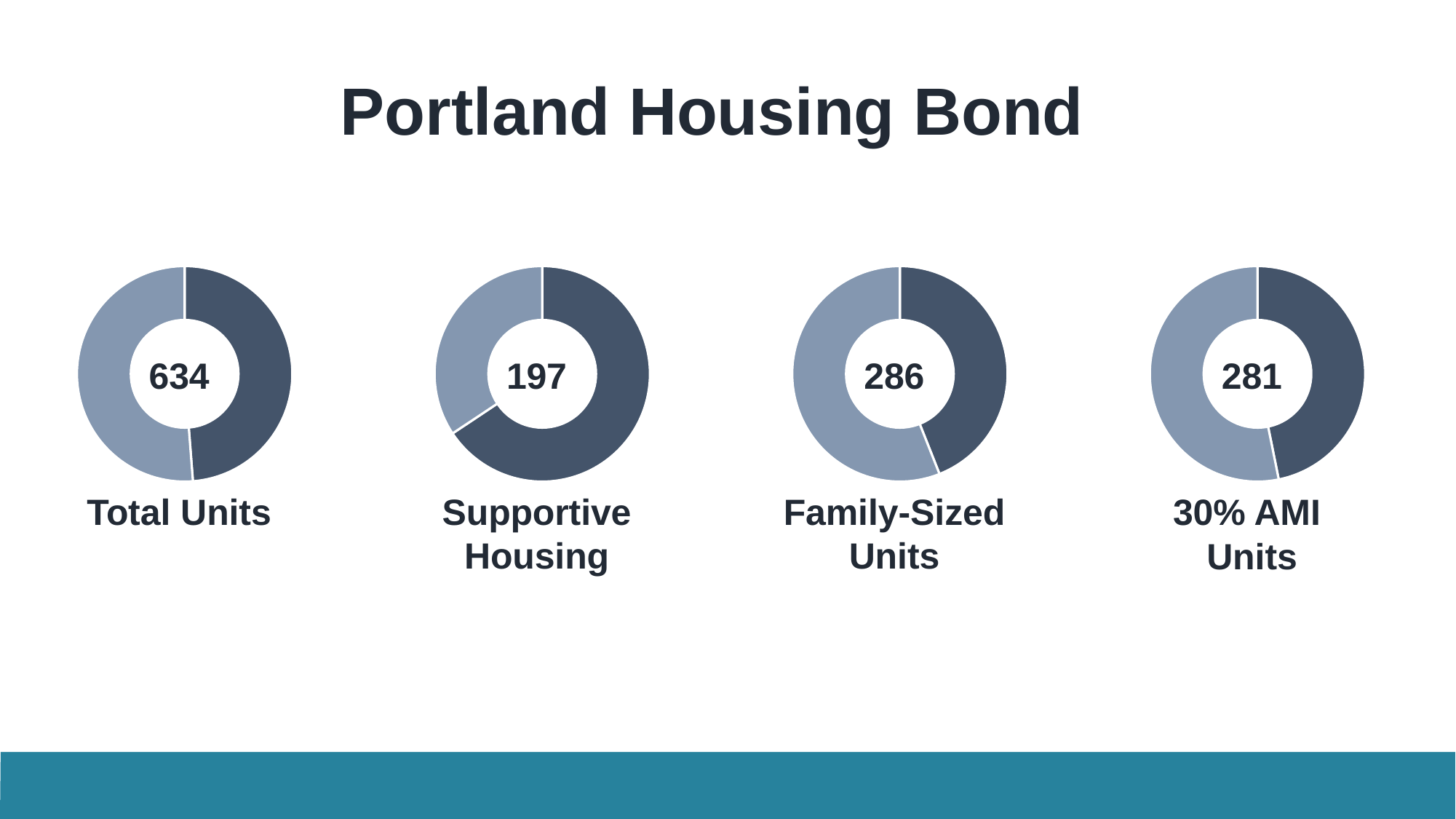
What number is shown in the center of the Total Units donut chart? 634 Which is larger, the Family-Sized Units number or the Supportive Housing number? Family-Sized Units What kind of chart is used for each of the four figures on the slide? Donut chart What number is shown in the center of the Supportive Housing donut chart? 197 What is the difference between the Total Units number and the Supportive Housing number? 437 Which of the four donut charts shows the smallest number in its center? Supportive Housing What number is shown in the center of the 30% AMI Units donut chart? 281 Which of the four donut charts shows the largest number in its center? Total Units What number is shown in the center of the Family-Sized Units donut chart? 286 What is the title of the slide? Portland Housing Bond How many donut charts are shown on the slide? 4 What is the difference between the Family-Sized Units number and the 30% AMI Units number? 5